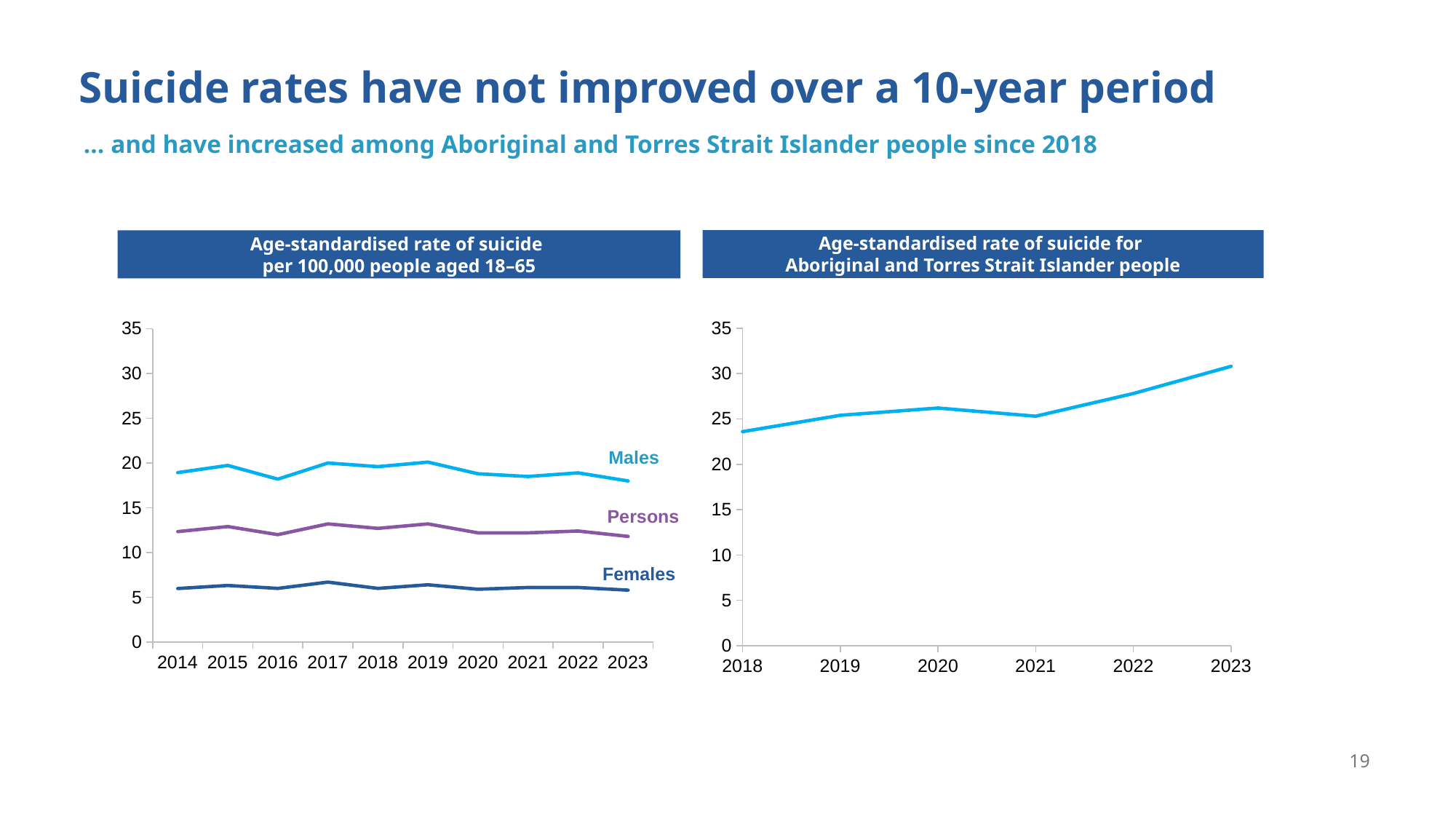
On the right chart, 'Age-standardised rate of suicide for Aboriginal and Torres Strait Islander people', which year has the highest value? 2023 On the right chart, 'Age-standardised rate of suicide for Aboriginal and Torres Strait Islander people', is the value for 2023 greater or less than 30? greater On the left chart, 'Age-standardised rate of suicide per 100,000 people aged 18–65', which is larger in 2020: the value for Males or the value for Females? Males On the left chart, 'Age-standardised rate of suicide per 100,000 people aged 18–65', which series has the highest values across all years? Males On the left chart, 'Age-standardised rate of suicide per 100,000 people aged 18–65', is the value for Persons in 2019 greater or less than 10? greater How many years are shown on the x axis of the right chart, 'Age-standardised rate of suicide for Aboriginal and Torres Strait Islander people'? 6 On the left chart, 'Age-standardised rate of suicide per 100,000 people aged 18–65', is the value for Females in 2017 greater or less than 10? less On the right chart, 'Age-standardised rate of suicide for Aboriginal and Torres Strait Islander people', do the values overall rise or fall from 2018 to 2023? Rise How many years are shown on the x axis of the left chart, 'Age-standardised rate of suicide per 100,000 people aged 18–65'? 10 How many series are plotted on the left chart, 'Age-standardised rate of suicide per 100,000 people aged 18–65'? 3 What kind of chart is the left chart, 'Age-standardised rate of suicide per 100,000 people aged 18–65'? Line chart